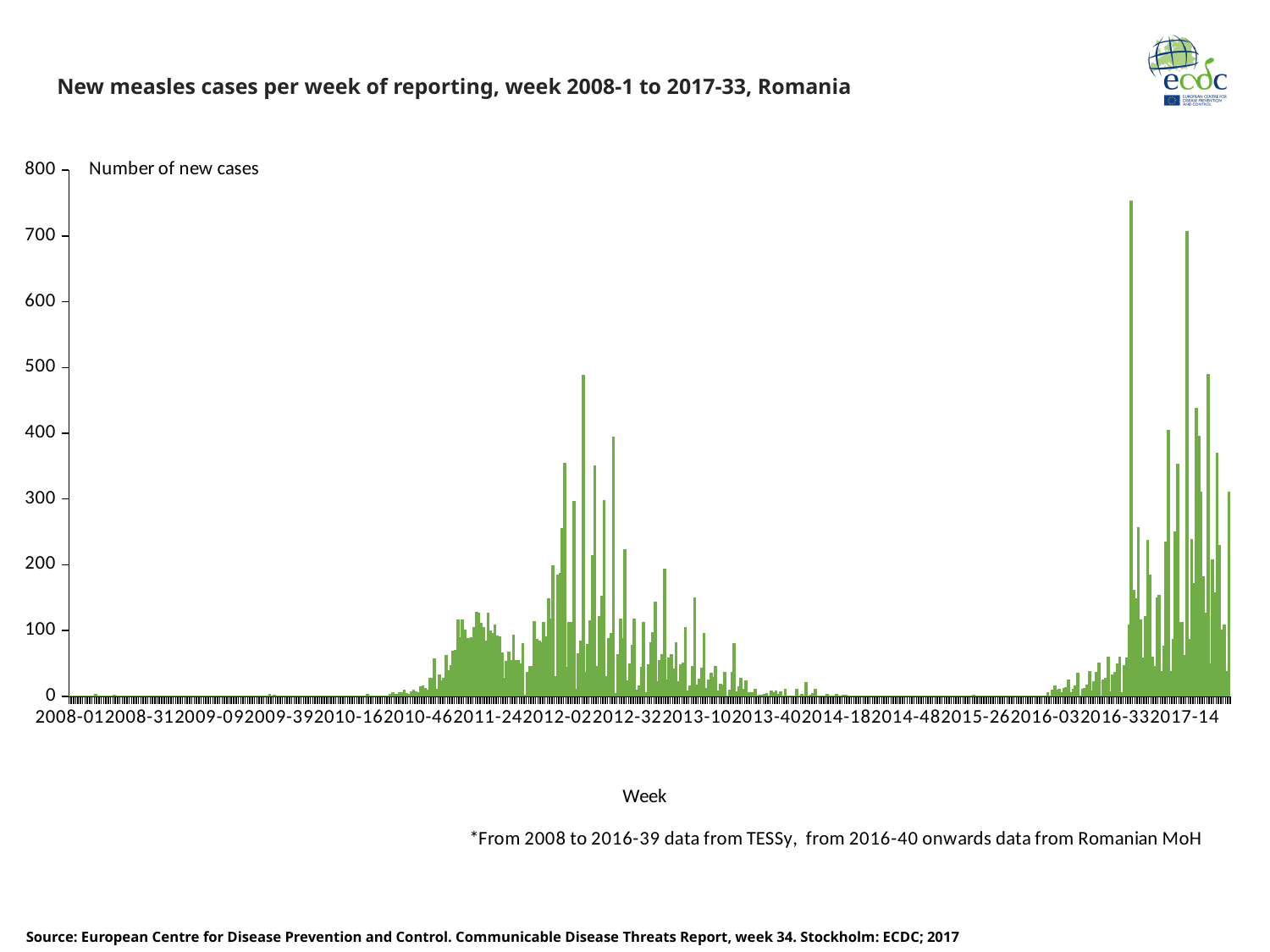
Is the tallest bar of the 2012 outbreak greater or less than 400? greater Which outbreak reached a higher weekly peak: the one around 2012 or the one around 2016-2017? The one around 2016-2017 Between which two horizontal-axis labels does the tallest bar of the chart appear? 2016-33 and 2017-14 What is the title of the chart? New measles cases per week of reporting, week 2008-1 to 2017-33, Romania What is the label of the vertical axis? Number of new cases Are the weekly values between the 2014-18 and 2015-26 labels greater or less than 100? less What is the highest value shown on the vertical axis? 800 Is the tallest bar in the chart greater or less than 700? greater How many week labels are printed along the horizontal axis? 17 What kind of chart is shown on the slide? Bar chart What is the last week label shown on the horizontal axis? 2017-14 What is the first week label shown on the horizontal axis? 2008-01